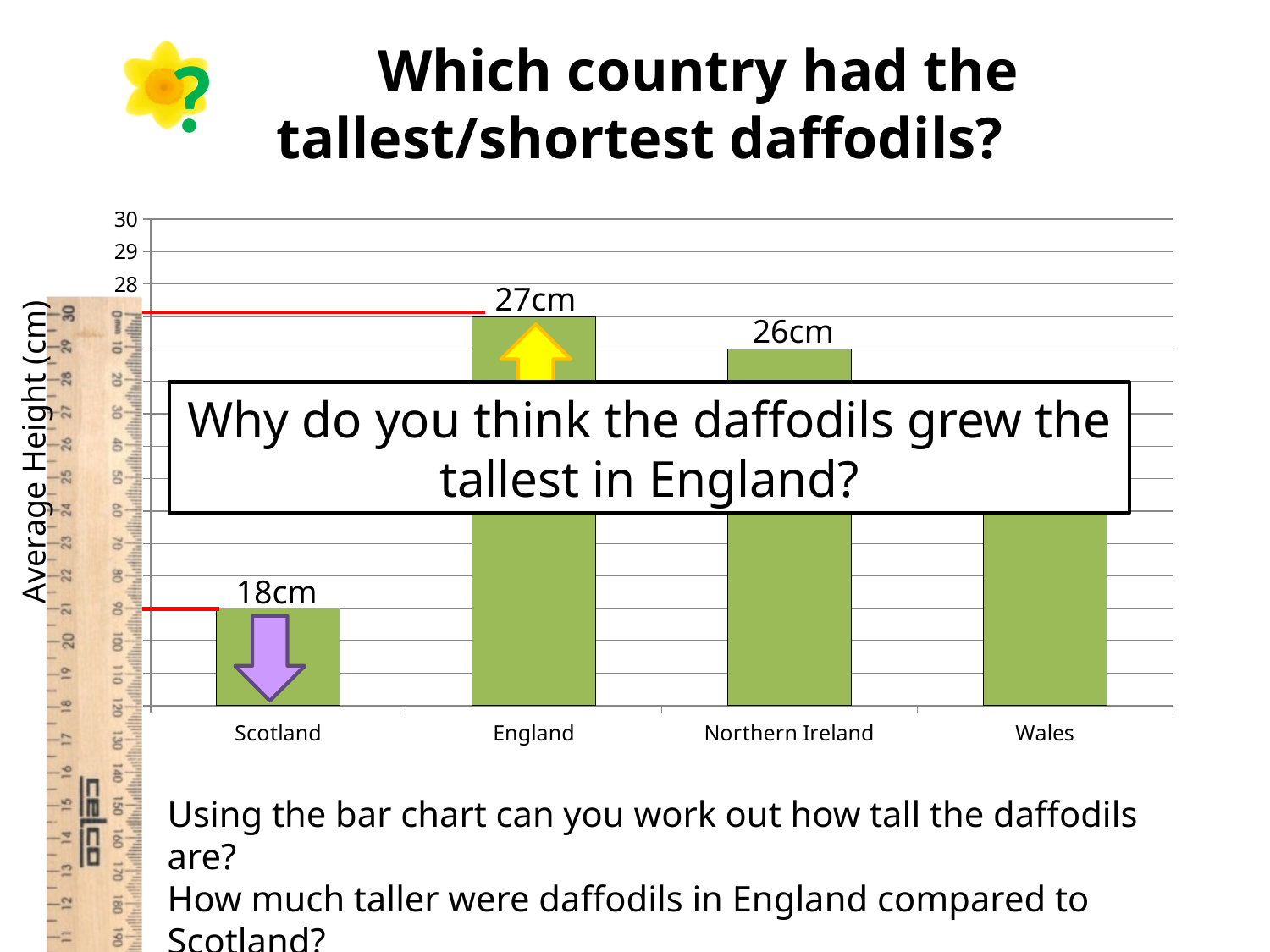
Which country has the tallest average daffodil height? England Which is larger, the value for Northern Ireland or the value for Scotland? Northern Ireland How many countries are shown on the chart? 4 Is the value for Wales greater or less than 28? less What is the average daffodil height for England? 27cm What kind of chart is shown on the slide? bar chart What is the title of the vertical axis? Average Height (cm) What is the difference between the average heights for England and Northern Ireland? 1cm What is the average daffodil height for Scotland? 18cm How much taller were the daffodils in England than in Scotland? 9cm What is the average daffodil height for Northern Ireland? 26cm Which country has the shortest average daffodil height? Scotland